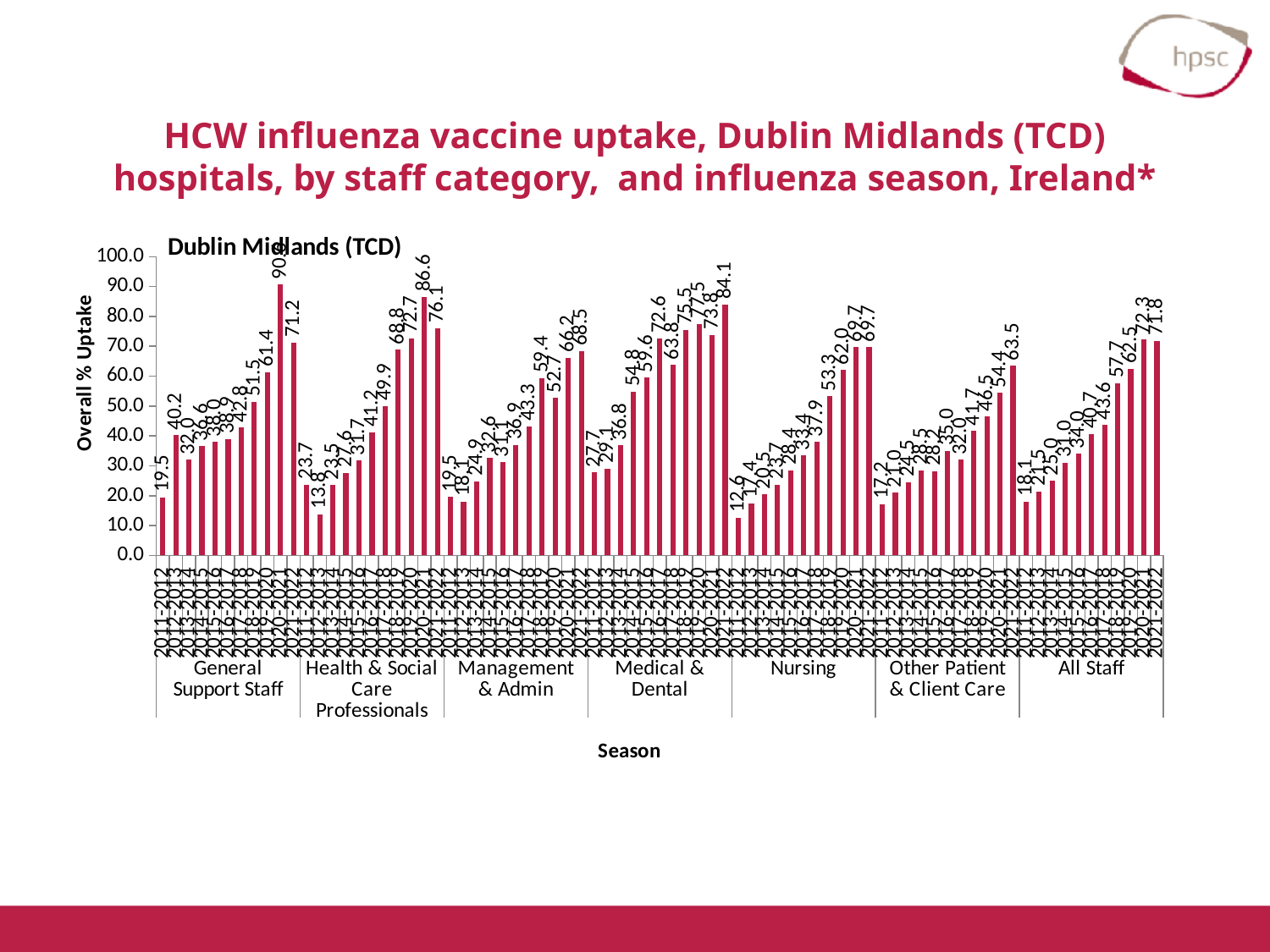
Which is larger: the last bar in the Medical & Dental category or the last bar in the Nursing category? Medical & Dental Is the first bar in the Nursing category greater or less than 20.0? less What is the lowest value shown for the Nursing staff category? 12.6 What is the highest value shown for the Medical & Dental staff category? 84.1 What type of chart is shown on the slide? bar chart What is the highest value shown for the Other Patient & Client Care category? 63.5 How many staff categories are shown along the x axis of the chart? 7 Do the All Staff values generally rise or fall across the seasons from 2011-2012 to 2020-2021? rise What is the difference between the two highest values in the All Staff category, 72.3 and 71.8? 0.5 What is the highest value shown for the Health & Social Care Professionals category? 86.6 What is the value of the last (2021-2022) bar in the All Staff category? 71.8 What is the lowest value shown for the Health & Social Care Professionals category? 13.8